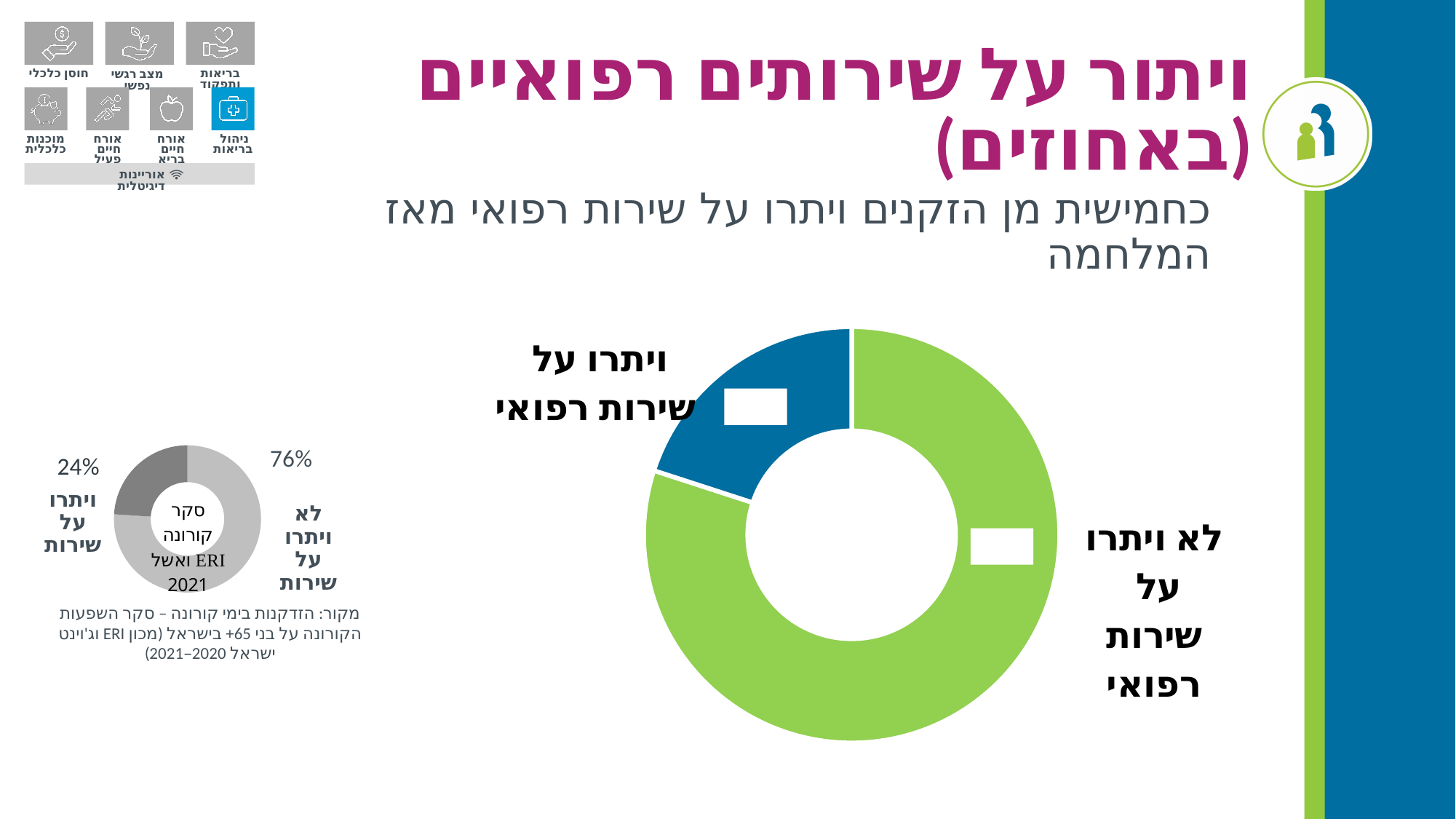
What kind of chart is the large chart in the centre of the slide? Donut (pie) chart In the small grey donut chart on the left (סקר קורונה ERI ואשל 2021), what is the value for 'לא ויתרו על שירות'? 76% What text is written in the centre of the small grey donut chart on the left? סקר קורונה ERI ואשל 2021 In the large donut chart in the centre, what colour is the slice for 'לא ויתרו על שירות רפואי'? Green In the small grey donut chart on the left (סקר קורונה ERI ואשל 2021), what is the value for 'ויתרו על שירות'? 24% How many slices does the large donut chart in the centre of the slide have? 2 How many slices does the small grey donut chart on the left (סקר קורונה ERI ואשל 2021) have? 2 What kind of chart is the small grey chart on the left of the slide? Donut (pie) chart In the small grey donut chart on the left (סקר קורונה ERI ואשל 2021), what is the difference between 'לא ויתרו על שירות' and 'ויתרו על שירות'? 52% In the large donut chart in the centre, which slice is larger: 'ויתרו על שירות רפואי' or 'לא ויתרו על שירות רפואי'? לא ויתרו על שירות רפואי In the large donut chart in the centre, which category has the smallest slice? ויתרו על שירות רפואי In the small grey donut chart on the left (סקר קורונה ERI ואשל 2021), which category has the highest value? לא ויתרו על שירות